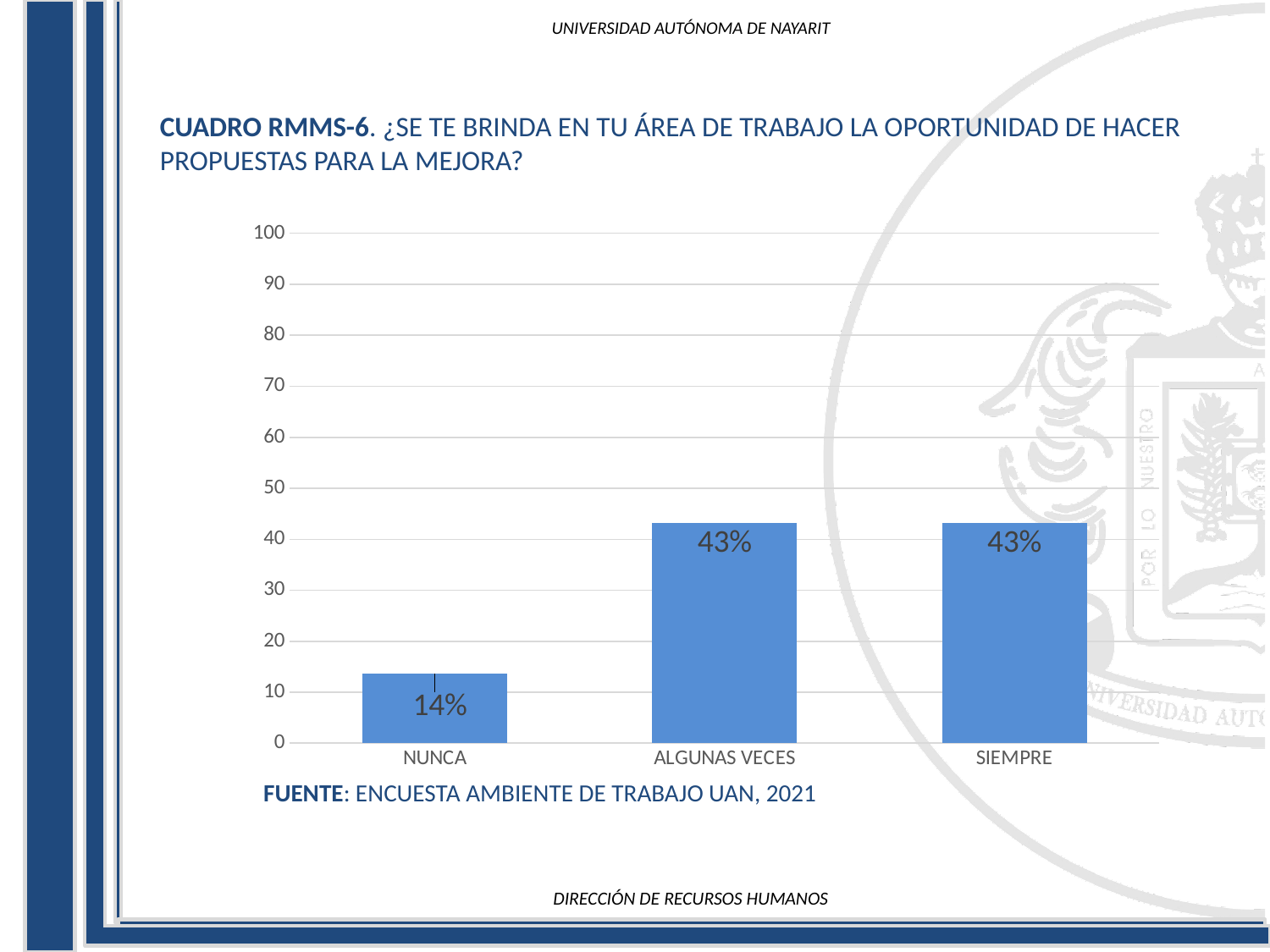
What source is cited below the chart? ENCUESTA AMBIENTE DE TRABAJO UAN, 2021 Is the value for NUNCA greater or less than 20? less What is the difference between the values for SIEMPRE and NUNCA? 29 percentage points Is the value for SIEMPRE greater or less than 50? less What is the value for SIEMPRE? 43% What kind of chart is shown on the slide? bar chart What is the value for ALGUNAS VECES? 43% How many categories are shown on the x axis? 3 Which category has the lowest value? NUNCA What is the value for NUNCA? 14% Do the values for ALGUNAS VECES and SIEMPRE have the same value? Yes Which is larger, the value for ALGUNAS VECES or the value for NUNCA? ALGUNAS VECES